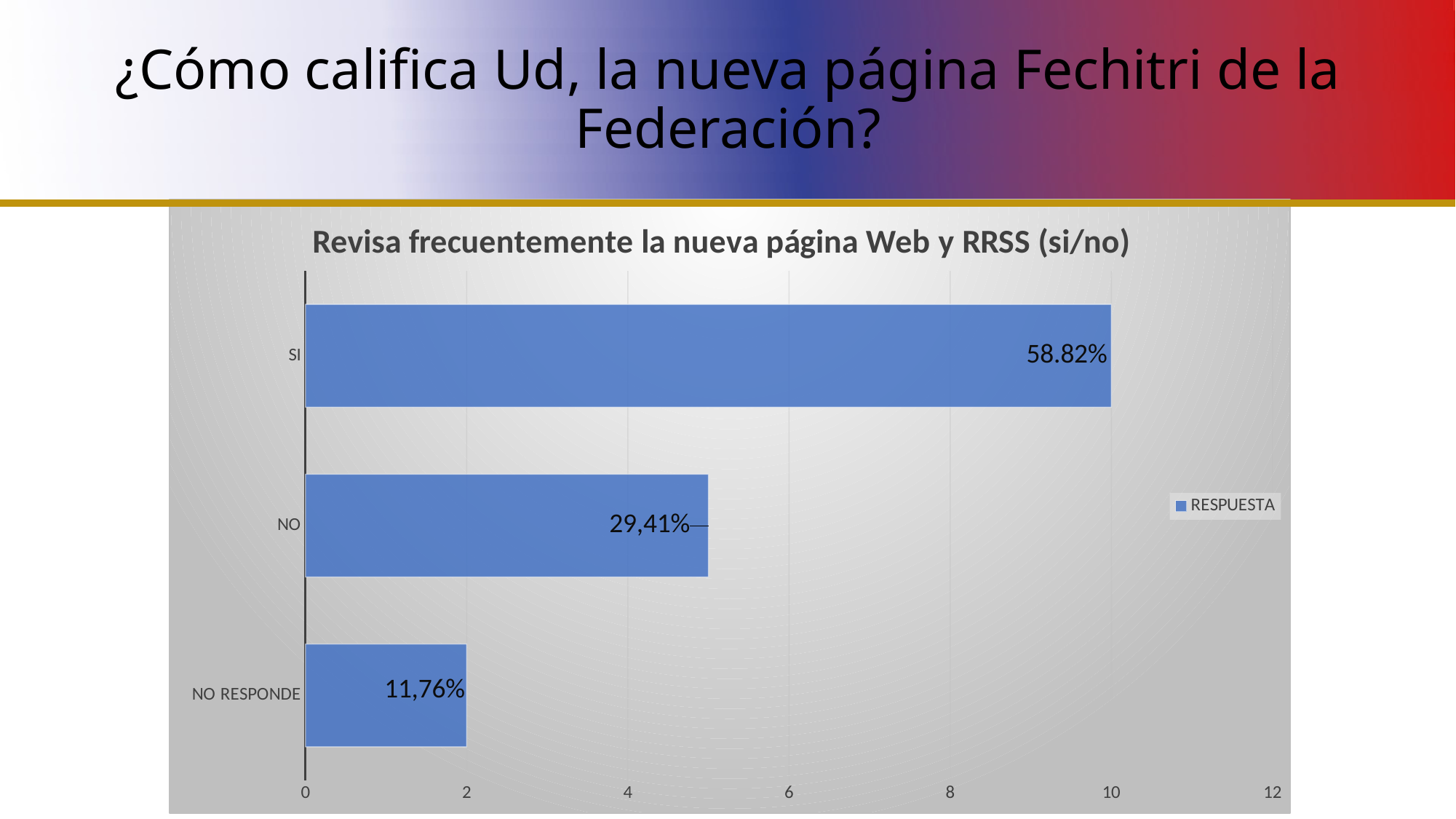
On the horizontal axis, what value does the NO RESPONDE bar reach? 2 Which category has the longest bar? SI What kind of chart is shown on the slide? Bar chart What is the data label shown on the NO RESPONDE bar? 11,76% Which category has the shortest bar? NO RESPONDE How many categories are shown in the chart? 3 What is the data label shown on the NO bar? 29,41% What is the name of the series listed in the legend? RESPUESTA What is the data label shown on the SI bar? 58.82% On the horizontal axis, what value does the SI bar reach? 10 Is the value for NO on the horizontal axis greater or less than 4? greater Which bar is longer, NO or NO RESPONDE? NO